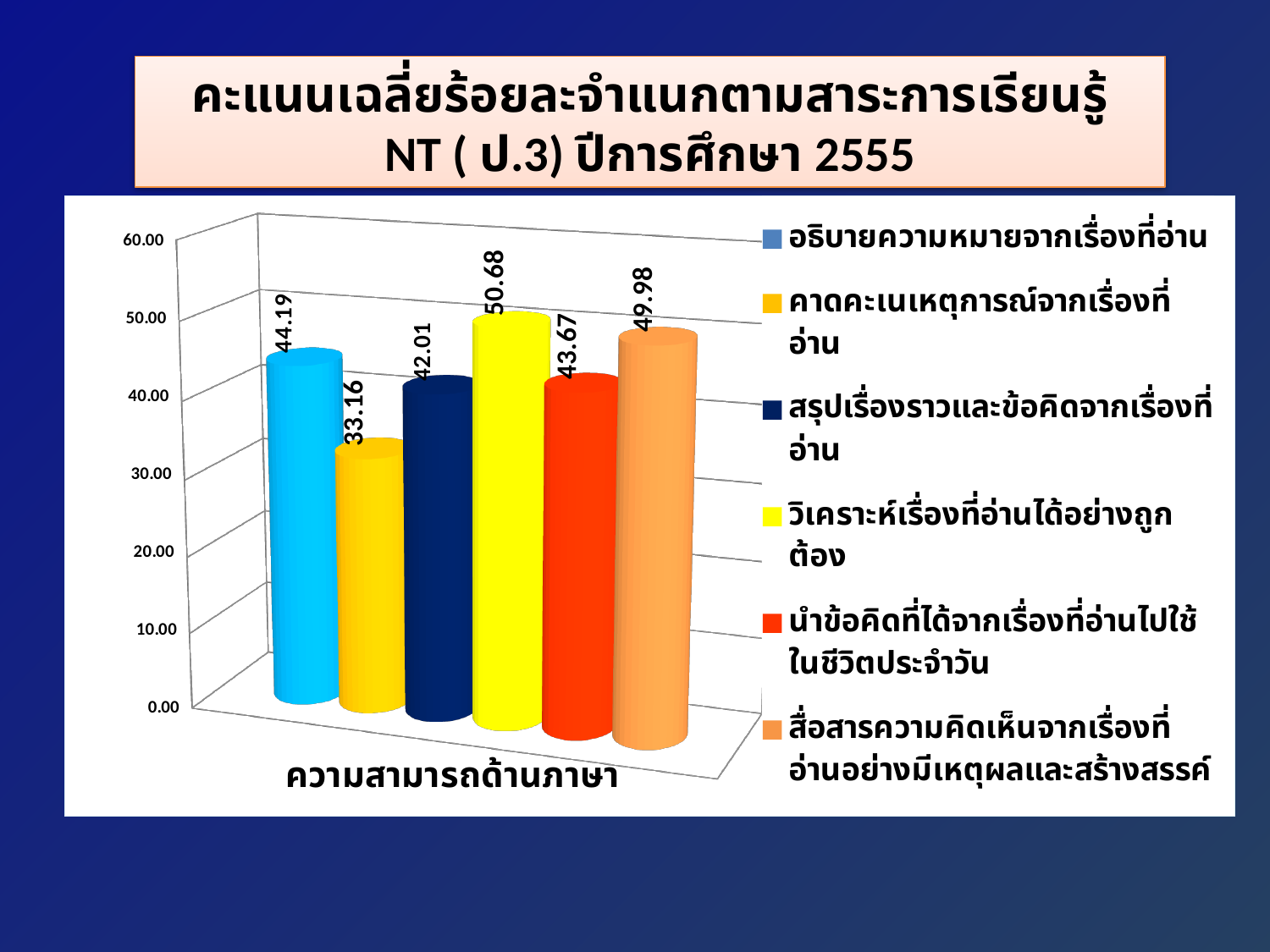
What is the difference between the values for วิเคราะห์เรื่องที่อ่านได้อย่างถูกต้อง and คาดคะเนเหตุการณ์จากเรื่องที่อ่าน? 17.52 Which series has the lowest value? คาดคะเนเหตุการณ์จากเรื่องที่อ่าน Which series has the highest value? วิเคราะห์เรื่องที่อ่านได้อย่างถูกต้อง What is the value for คาดคะเนเหตุการณ์จากเรื่องที่อ่าน? 33.16 What is the value for สรุปเรื่องราวและข้อคิดจากเรื่องที่อ่าน? 42.01 What is the value for วิเคราะห์เรื่องที่อ่านได้อย่างถูกต้อง? 50.68 How many series does the legend list? 6 What type of chart is shown on the slide? bar chart What is the value for สื่อสารความคิดเห็นจากเรื่องที่อ่านอย่างมีเหตุผลและสร้างสรรค์? 49.98 What is the category label shown on the x axis? ความสามารถด้านภาษา What is the value for อธิบายความหมายจากเรื่องที่อ่าน? 44.19 Which is larger: the value for อธิบายความหมายจากเรื่องที่อ่าน or the value for นำข้อคิดที่ได้จากเรื่องที่อ่านไปใช้ในชีวิตประจำวัน? อธิบายความหมายจากเรื่องที่อ่าน